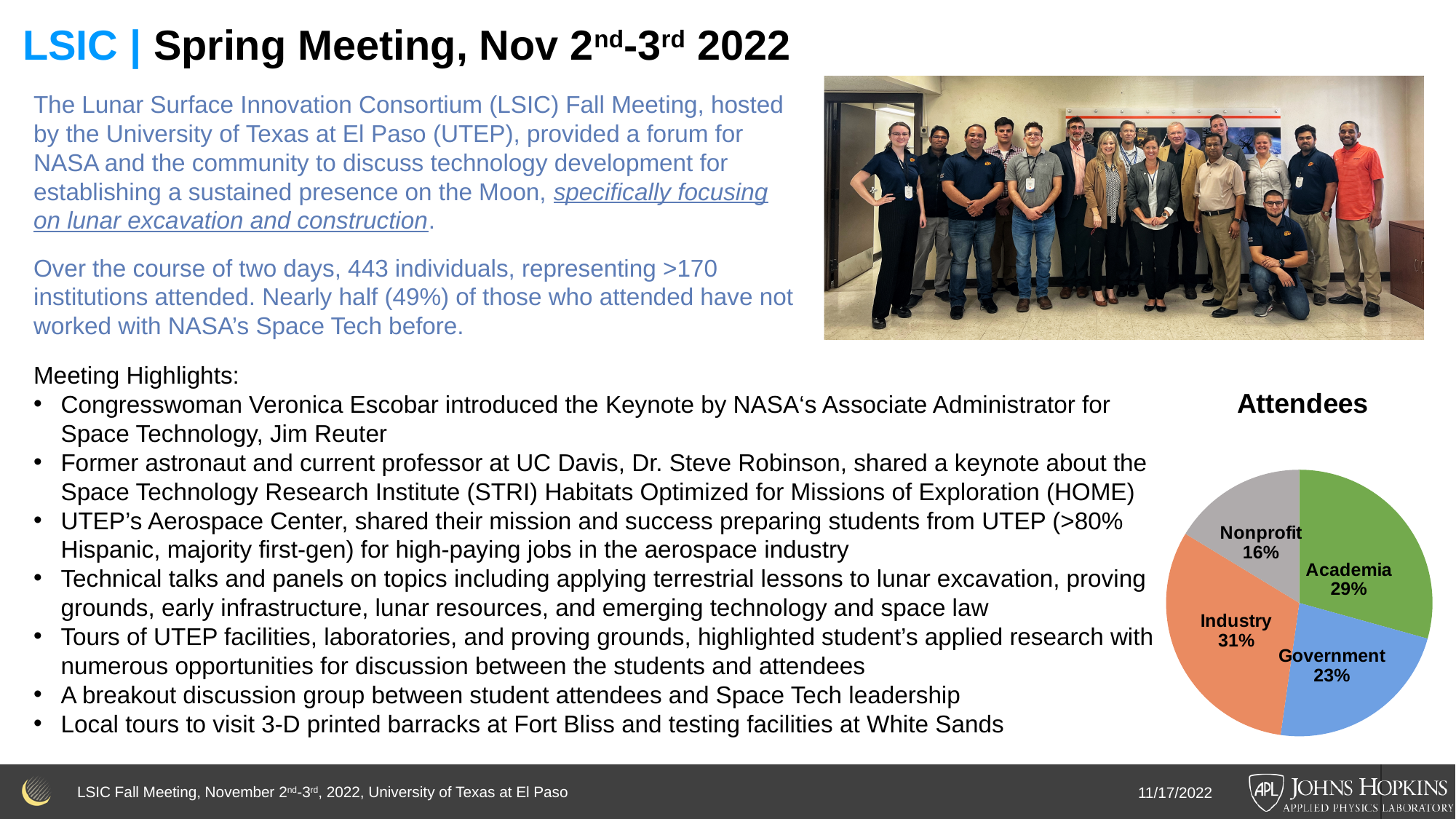
Which category has the smallest share in the Attendees pie chart? Nonprofit Which category has the largest share in the Attendees pie chart? Industry What colour is the Industry slice in the Attendees pie chart? orange What is the title of the pie chart on the slide? Attendees What share of attendees is Nonprofit in the Attendees pie chart? 16% What share of attendees is Academia in the Attendees pie chart? 29% What share of attendees is Industry in the Attendees pie chart? 31% How many slices does the Attendees pie chart have? 4 In the Attendees pie chart, which is larger: Academia or Government? Academia In the Attendees pie chart, what is the difference between the Industry and Nonprofit shares? 15% What kind of chart is the Attendees chart? pie chart